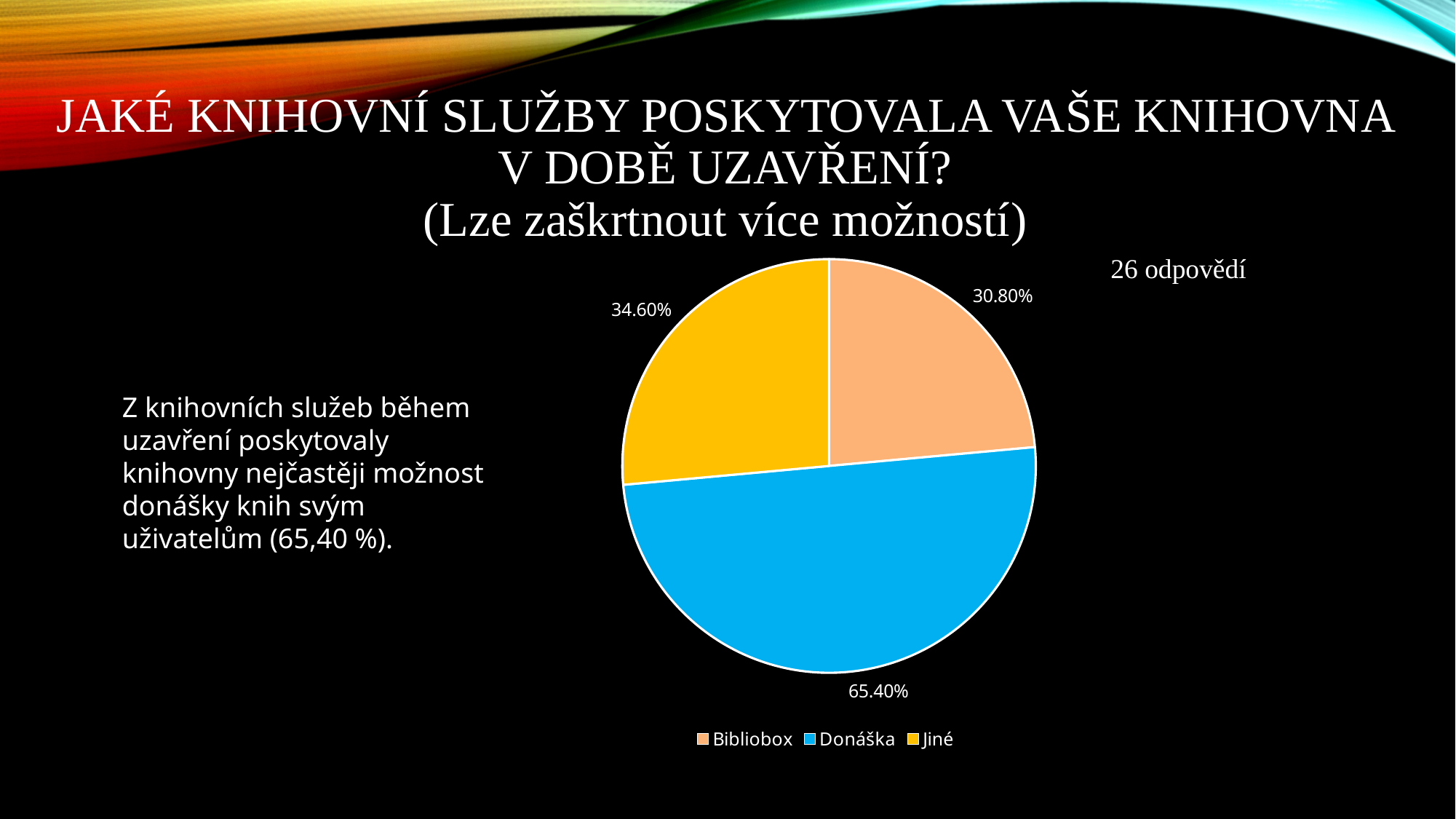
What percentage is shown for Bibliobox? 30.80% What percentage is shown for Donáška? 65.40% Which category has the largest slice of the pie? Donáška What is the difference between the percentages for Donáška and Jiné? 30.80% What is the difference between the percentages for Jiné and Bibliobox? 3.80% How many categories does the pie chart show? 3 What type of chart is shown on the slide? pie chart What colour is the Donáška slice in the pie chart? blue Which is larger, the percentage for Jiné or for Bibliobox? Jiné How many entries does the legend list? 3 Which category has the smallest slice of the pie? Bibliobox What percentage is shown for Jiné? 34.60%